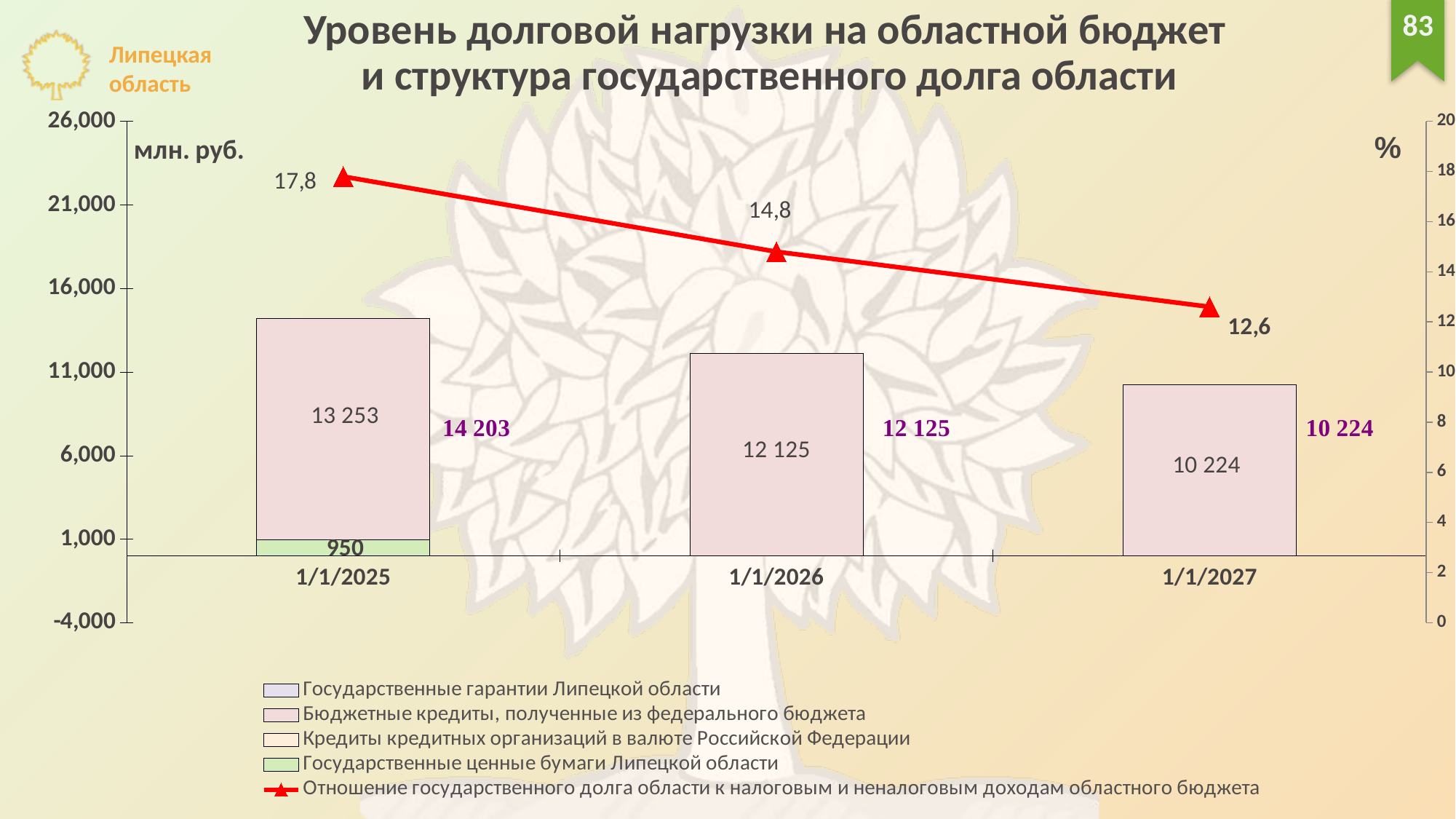
What is the value of the 'Государственные ценные бумаги Липецкой области' segment for 1/1/2025? 950 How many series does the legend list? 5 What is the value of the 'Бюджетные кредиты, полученные из федерального бюджета' segment for 1/1/2027? 10 224 At which date is the total stacked bar lowest? 1/1/2027 What is the value of the 'Бюджетные кредиты, полученные из федерального бюджета' segment for 1/1/2025? 13 253 Which is larger: the line value at 1/1/2025 or at 1/1/2027? 1/1/2025 What is the difference between the 'Бюджетные кредиты, полученные из федерального бюджета' values for 1/1/2026 and 1/1/2027? 1 901 Does the line 'Отношение государственного долга области к налоговым и неналоговым доходам областного бюджета' rise or fall from 1/1/2025 to 1/1/2027? fall What is the total of the stacked bar for 1/1/2025? 14 203 How many dates are shown on the x axis? 3 What is the value of the line 'Отношение государственного долга области к налоговым и неналоговым доходам областного бюджета' at 1/1/2026? 14,8 At which date is the line 'Отношение государственного долга области к налоговым и неналоговым доходам областного бюджета' highest? 1/1/2025